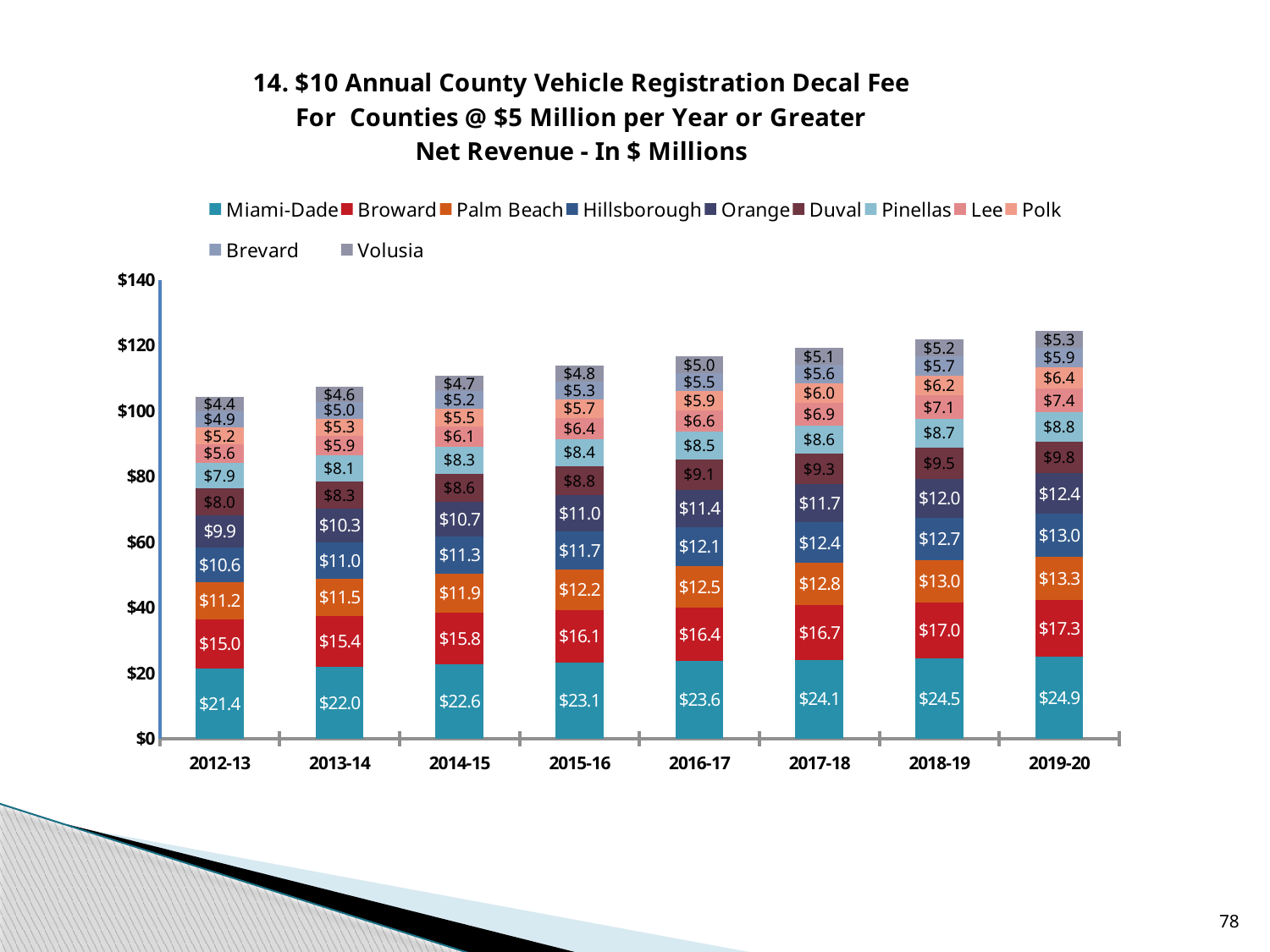
What kind of chart is shown on the slide? stacked bar chart What is the value for Broward in 2019-20? $17.3 What is the value for Miami-Dade in 2012-13? $21.4 What is the value for Volusia in 2015-16? $4.8 Do the total bar heights rise or fall from 2012-13 to 2019-20? rise Which year has the highest total stacked bar? 2019-20 How many years are shown on the x axis? 8 Is the total for the 2019-20 bar greater or less than $120? greater Which year has the lowest total stacked bar? 2012-13 How many series does the legend list? 11 In 2019-20, which is larger: the Palm Beach value or the Hillsborough value? Palm Beach How much larger is the Miami-Dade value in 2019-20 than in 2012-13? $3.5